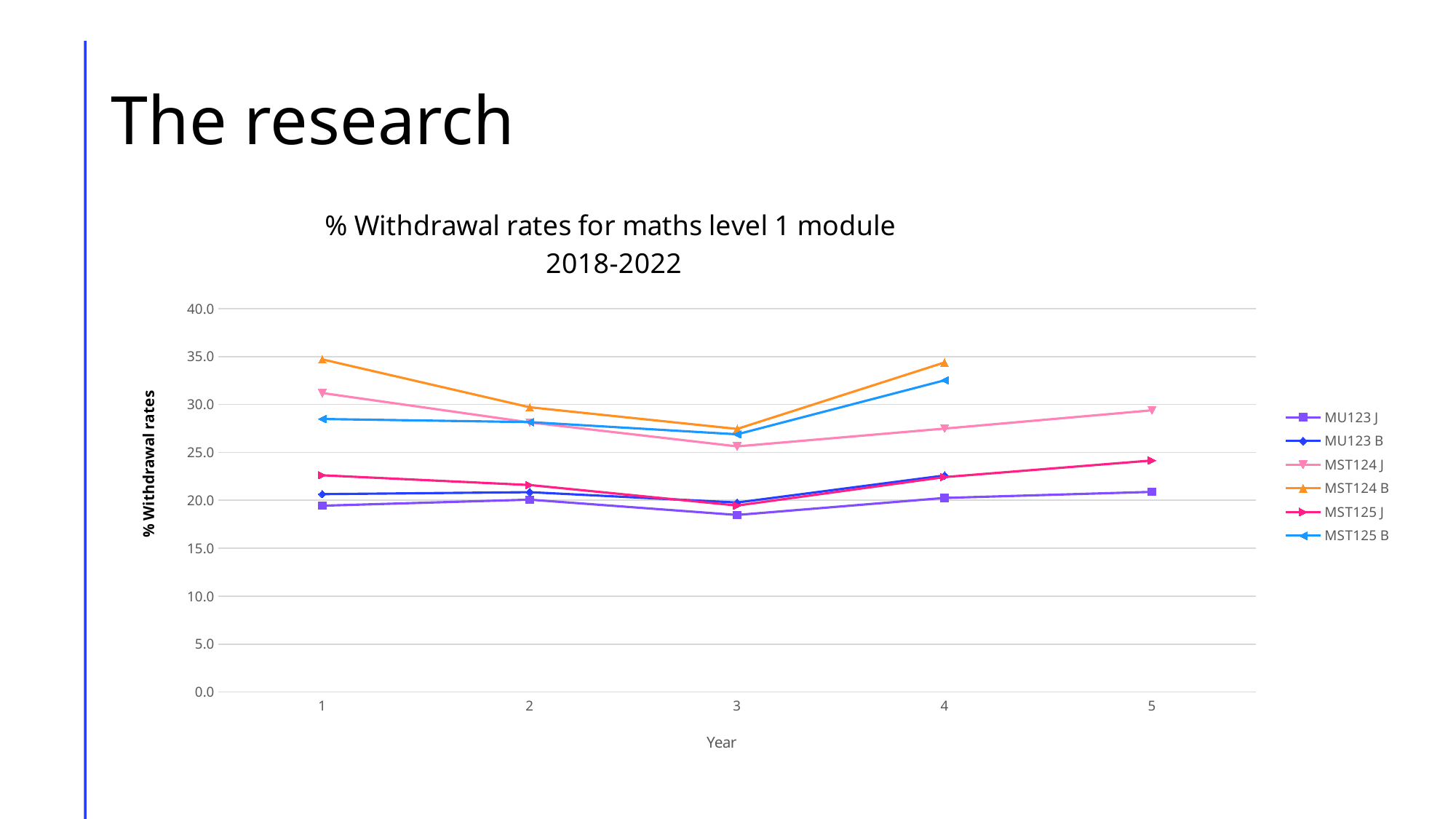
Which series has the lowest withdrawal rate in year 3? MU123 J What is the label on the y axis of the chart? % Withdrawal rates Does the MST124 B line rise or fall from year 1 to year 3? Fall What kind of chart is shown on the slide? Line chart In year 1, which is larger: the value for MST124 B or the value for MST125 B? MST124 B Is the value for MU123 J in year 3 greater or less than 20? less Is the value for MST125 B in year 4 greater or less than 30? greater How many year categories are shown on the x axis? 5 Is the value for MST124 B in year 1 greater or less than 30? greater Which series has the highest withdrawal rate in year 5? MST124 J How many series does the legend list? 6 Which series has the highest withdrawal rate in year 1? MST124 B